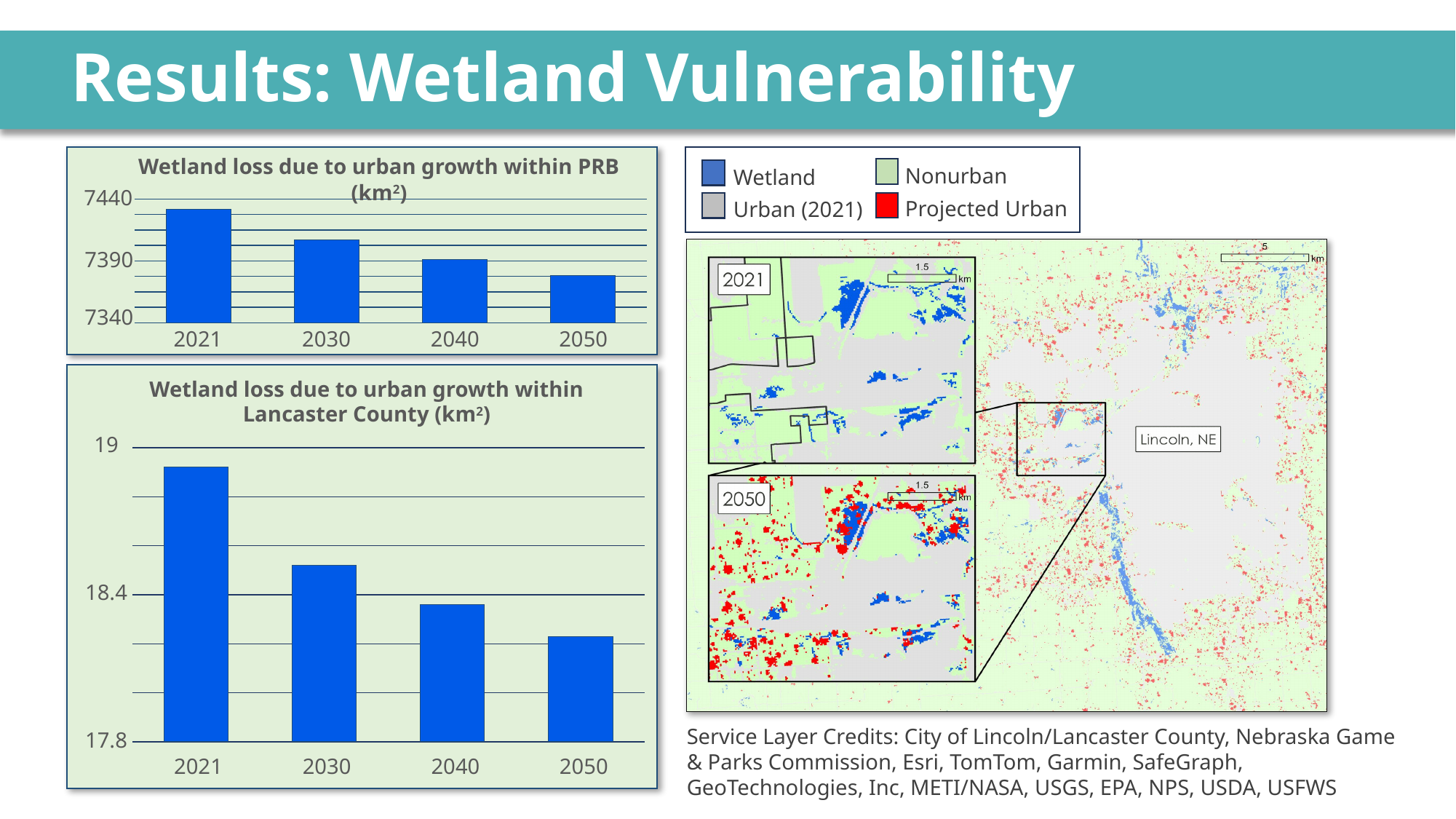
What is the title of the lower chart on the left side of the slide? Wetland loss due to urban growth within Lancaster County (km²) In the chart 'Wetland loss due to urban growth within Lancaster County (km²)', is the value for 2030 greater or less than 18.4? greater In the chart 'Wetland loss due to urban growth within Lancaster County (km²)', which is larger, the value for 2030 or the value for 2050? 2030 In the chart 'Wetland loss due to urban growth within PRB (km²)', which year has the lowest value? 2050 In the chart 'Wetland loss due to urban growth within Lancaster County (km²)', which year has the lowest value? 2050 In the chart 'Wetland loss due to urban growth within PRB (km²)', is the value for 2050 greater or less than 7390? less In the chart 'Wetland loss due to urban growth within PRB (km²)', which year has the highest value? 2021 In the chart 'Wetland loss due to urban growth within PRB (km²)', is the value for 2021 greater or less than 7390? greater In the chart 'Wetland loss due to urban growth within PRB (km²)', do the values rise or fall from 2021 to 2050? fall In the chart 'Wetland loss due to urban growth within PRB (km²)', how many years are plotted on the x axis? 4 In the chart 'Wetland loss due to urban growth within PRB (km²)', what kind of chart is shown? bar chart In the chart 'Wetland loss due to urban growth within Lancaster County (km²)', which year has the highest value? 2021